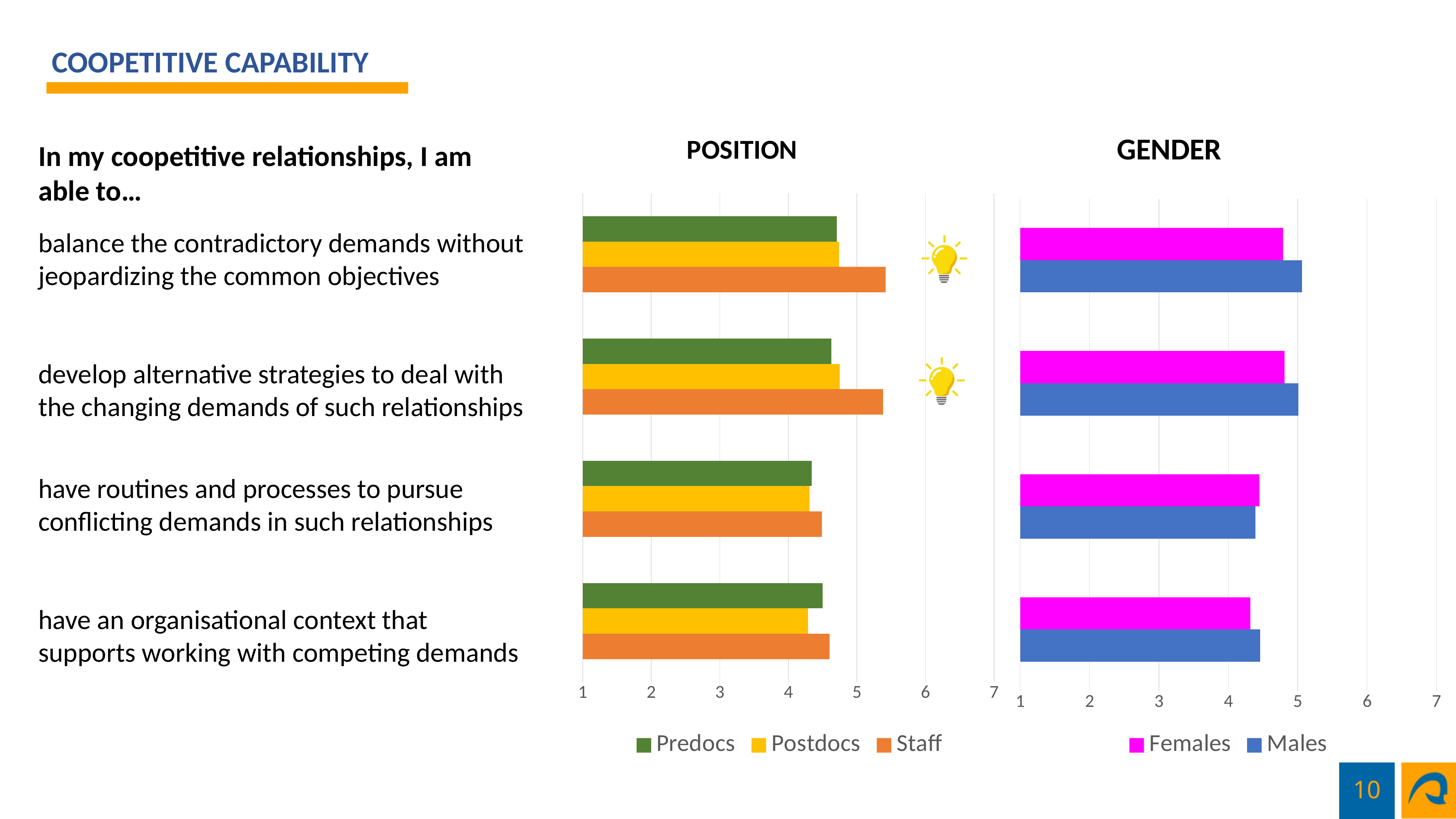
In the GENDER chart, is the Females value for 'have an organisational context that supports working with competing demands' greater or less than 5? less How many series does the legend of the POSITION chart list? 3 In the POSITION chart, is the Staff value for 'have routines and processes to pursue conflicting demands in such relationships' greater or less than 5? less In the GENDER chart, which colour represents Females? magenta In the POSITION chart, which series has the highest value for 'develop alternative strategies to deal with the changing demands of such relationships'? Staff What kind of chart is the POSITION chart? bar chart In the GENDER chart, which is larger for 'have an organisational context that supports working with competing demands', Females or Males? Males How many statements (categories) are plotted in the GENDER chart? 4 How many series does the legend of the GENDER chart list? 2 In the POSITION chart, is the Staff value for 'balance the contradictory demands without jeopardizing the common objectives' greater or less than 5? greater In the GENDER chart, which is larger for 'balance the contradictory demands without jeopardizing the common objectives', Females or Males? Males